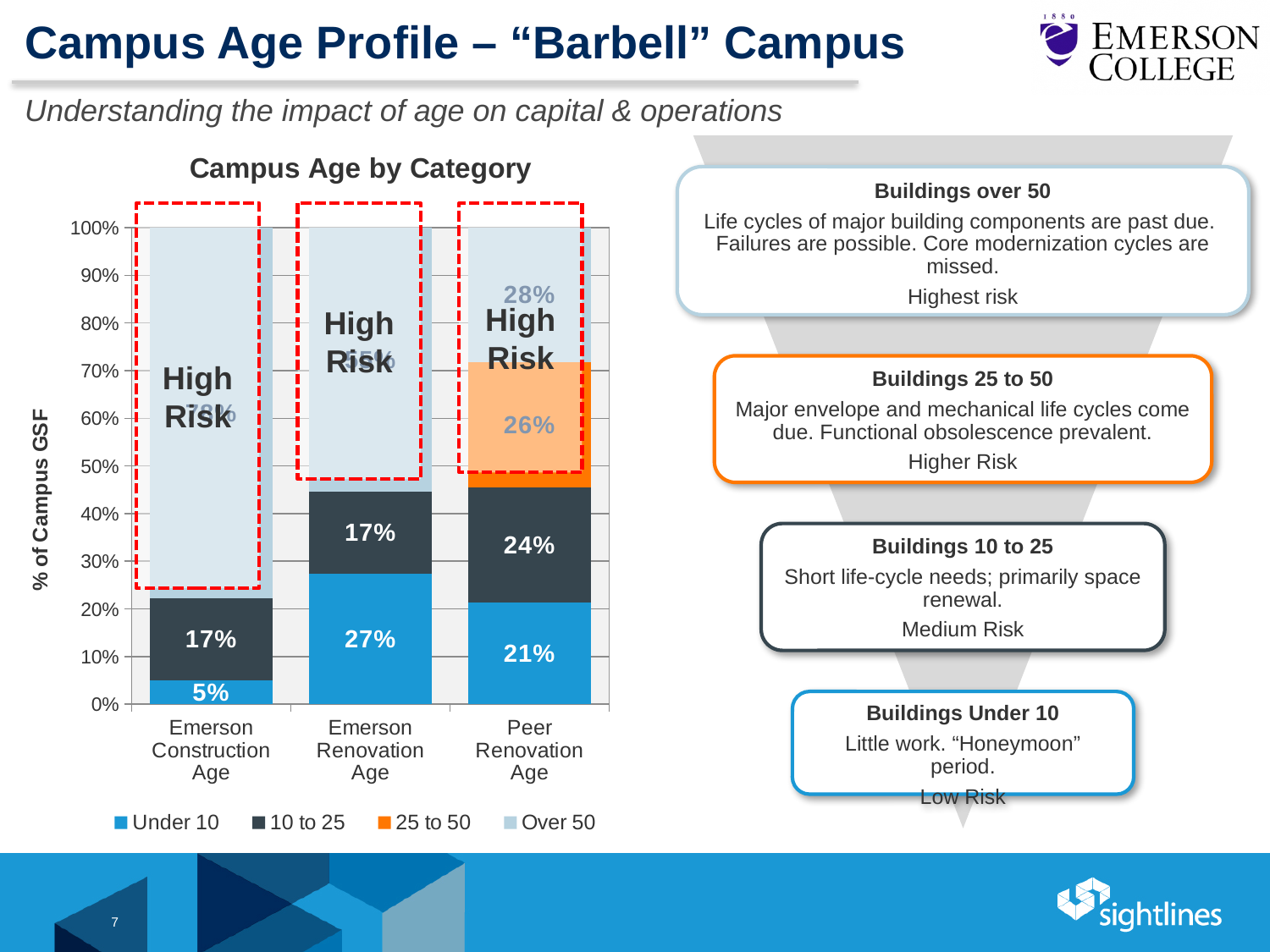
Which category has the highest "Under 10" value? Emerson Renovation Age What is the "25 to 50" value for Peer Renovation Age? 26% Is the "Over 50" value for Emerson Construction Age greater or less than 70%? greater What is the difference between the "10 to 25" value for Peer Renovation Age and the "10 to 25" value for Emerson Construction Age? 7 percentage points How many series does the legend of the "Campus Age by Category" chart list? 4 What is the "Under 10" value for Emerson Construction Age? 5% Which category has the lowest "Under 10" value? Emerson Construction Age What is the "Over 50" value for Peer Renovation Age? 28% What kind of chart is shown under the title "Campus Age by Category"? Stacked bar chart What is the "10 to 25" value for Emerson Renovation Age? 17% Which has the larger "Under 10" value, Emerson Renovation Age or Peer Renovation Age? Emerson Renovation Age How many categories are shown on the x axis of the "Campus Age by Category" chart? 3